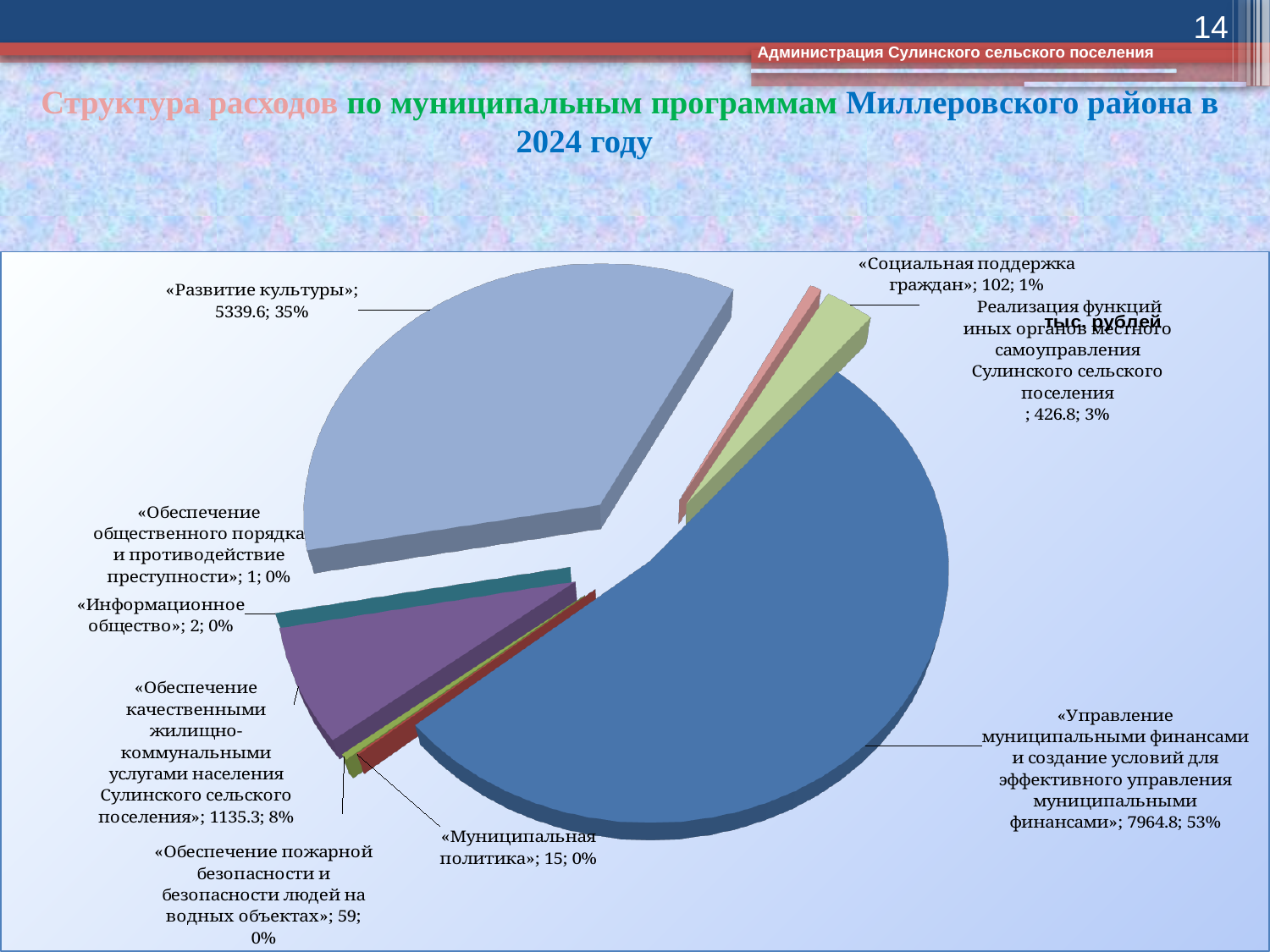
What kind of chart is shown on the slide? pie chart What is the value for «Обеспечение качественными жилищно-коммунальными услугами населения Сулинского сельского поселения»? 1135.3 Which category has the largest slice of the pie? «Управление муниципальными финансами и создание условий для эффективного управления муниципальными финансами» Which category has the smallest value? «Обеспечение общественного порядка и противодействие преступности» What is the value for «Управление муниципальными финансами и создание условий для эффективного управления муниципальными финансами»? 7964.8 What is the difference between the values for «Управление муниципальными финансами...» (7964.8) and «Развитие культуры» (5339.6)? 2625.2 What is the value for «Развитие культуры»? 5339.6 What share of the pie does «Развитие культуры» represent? 35% Which is larger: the value for «Муниципальная политика» or the value for «Обеспечение пожарной безопасности и безопасности людей на водных объектах»? «Обеспечение пожарной безопасности и безопасности людей на водных объектах» What share of the pie does Реализация функций иных органов местного самоуправления Сулинского сельского поселения represent? 3% How many slices (categories) does the pie chart have? 9 What is the value for «Социальная поддержка граждан»? 102